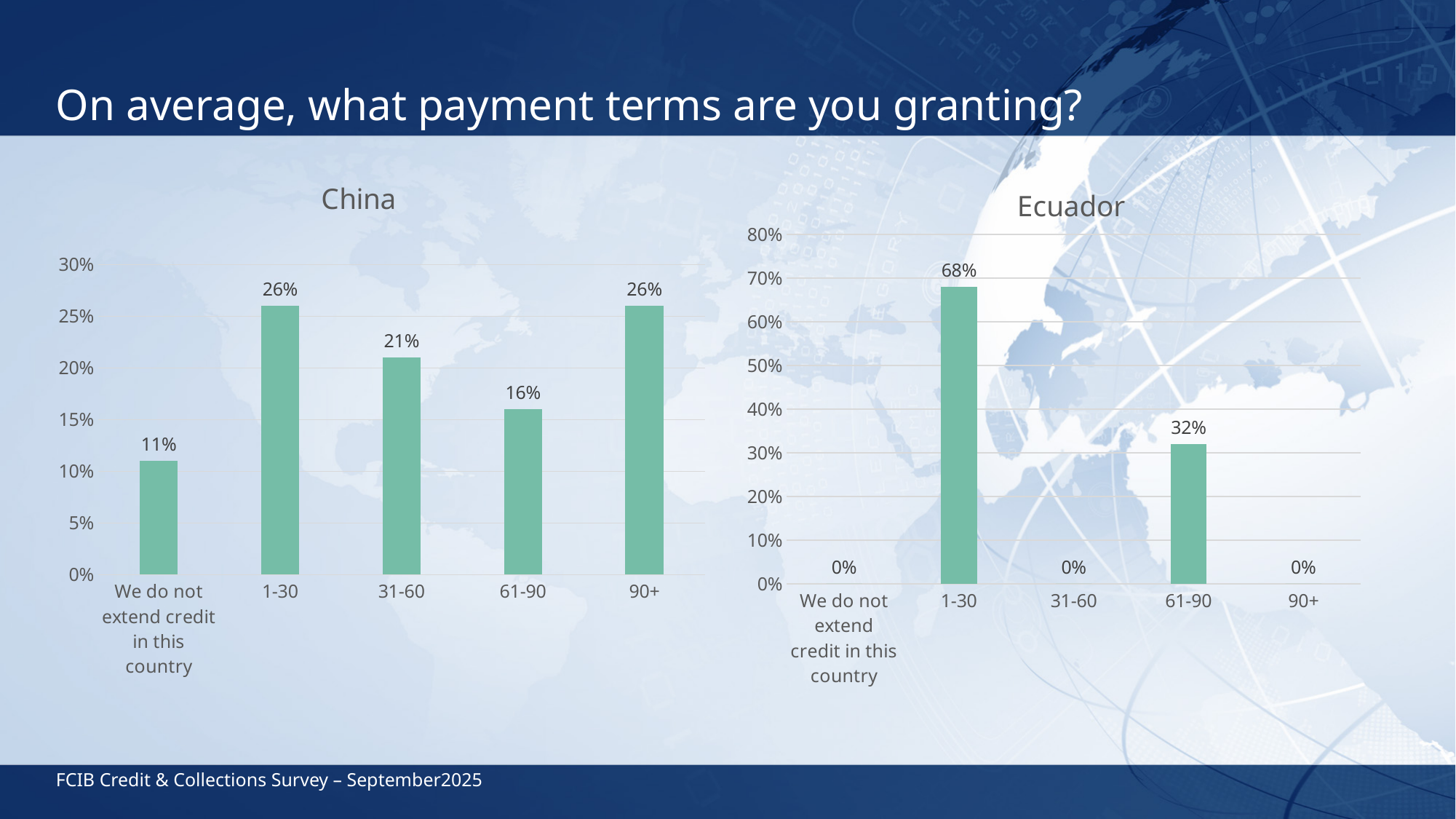
In the China chart, which category has the lowest value? We do not extend credit in this country In the China chart, what is the value for 'We do not extend credit in this country'? 11% In the Ecuador chart, what is the difference between the values for 1-30 and 61-90? 36% In the Ecuador chart, which category has the highest value? 1-30 How many categories are shown in the Ecuador chart? 5 In the Ecuador chart, what is the value for 61-90? 32% In the Ecuador chart, how many categories have a value of 0%? 3 In the China chart, what is the value for 31-60? 21% In the China chart, which is larger, the value for 31-60 or the value for 61-90? 31-60 In the China chart, what is the difference between the values for 1-30 and 61-90? 10% In the Ecuador chart, what is the value for 1-30? 68% What kind of chart is the China chart? Bar chart